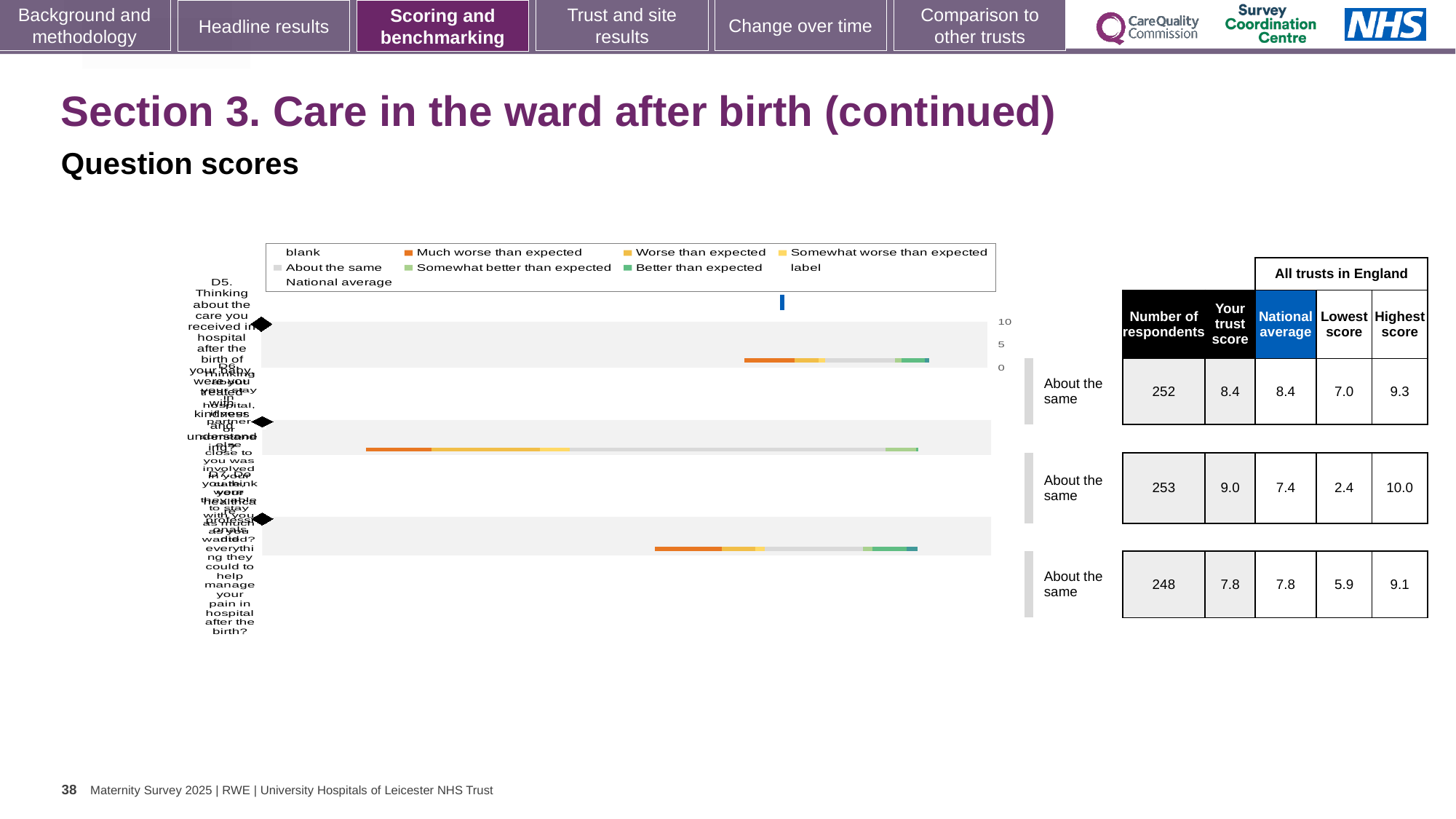
In the table next to the chart, what is the difference between the trust score and the national average for the middle row? 1.6 In the table next to the chart, which row has the highest 'Your trust score'? the middle row (9.0) In the table next to the chart, is the trust score for the top row larger or smaller than the trust score for the bottom row? larger In the table next to the chart, what is the national average for the bottom row? 7.8 What benchmark category is shown for all three rows beside the chart? About the same Which legend entry is shown in orange in the chart? Much worse than expected In the table next to the chart, what is the number of respondents for the top row? 252 What kind of chart is shown on the slide? bar chart What is the highest tick value shown on the chart's axis? 10 In the table next to the chart, what is the trust score for the middle row? 9.0 How many bars (question rows) are plotted in the chart? 3 In the table next to the chart, which row has the lowest 'Lowest score'? the middle row (2.4)